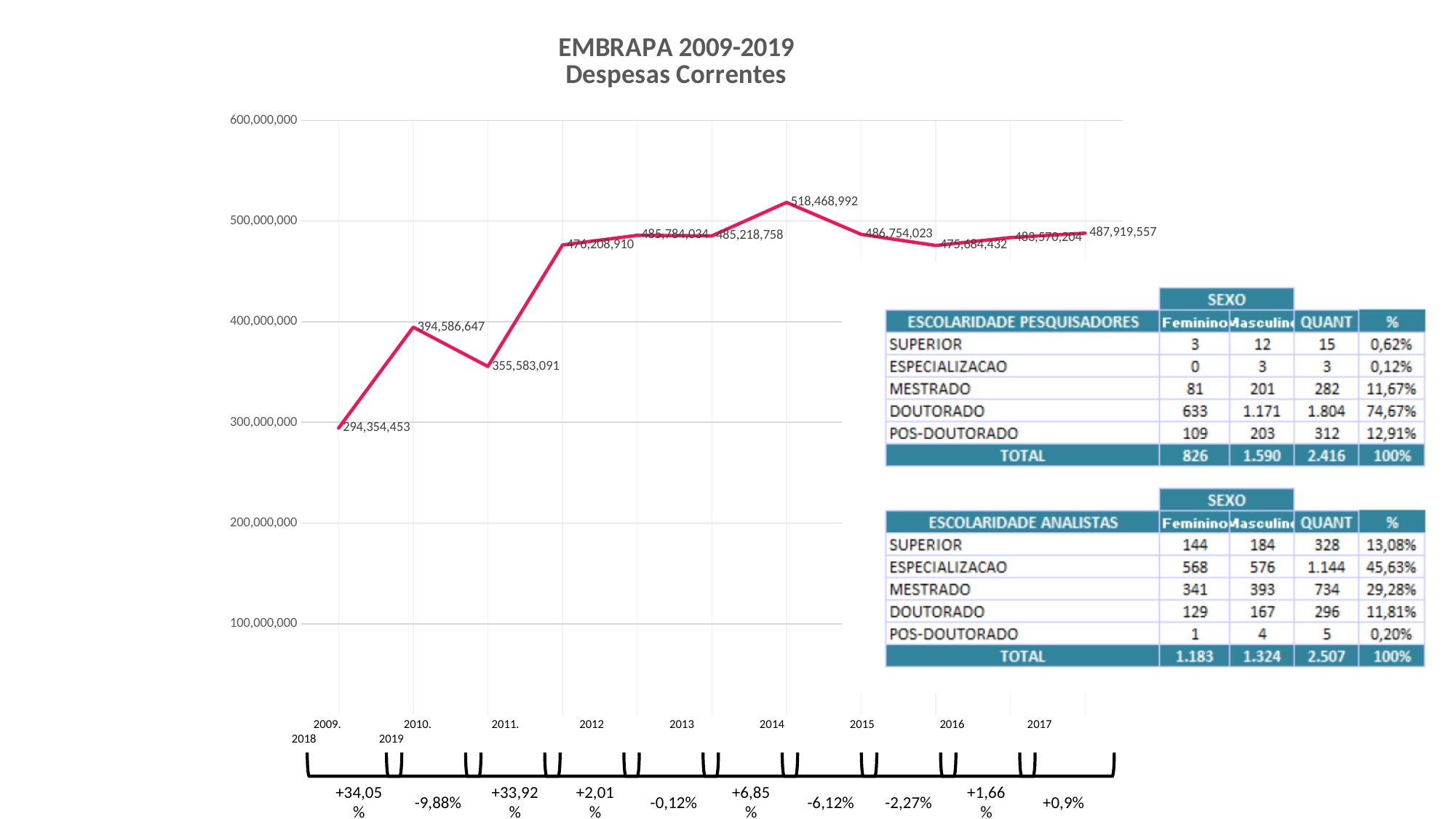
What is the lowest value shown on the Despesas Correntes line? 294,354,453 Is the value of the first plotted point on the Despesas Correntes line greater or less than 300,000,000? less What is the title of the chart on the slide? EMBRAPA 2009-2019 Despesas Correntes What is the difference between the highest and lowest values on the Despesas Correntes line? 224,114,539 What is the value of the last plotted point on the Despesas Correntes line? 487,919,557 What is the highest value shown on the Despesas Correntes line? 518,468,992 What is the difference between the second plotted point (394,586,647) and the first plotted point (294,354,453)? 100,232,194 Overall, do the Despesas Correntes values rise or fall from the first point to the last point? rise Which is larger on the Despesas Correntes line: the second plotted point or the third plotted point? the second plotted point (394,586,647) How many data points are plotted on the Despesas Correntes line? 11 What is the value of the first plotted point on the Despesas Correntes line? 294,354,453 What kind of chart is used to show Despesas Correntes? line chart